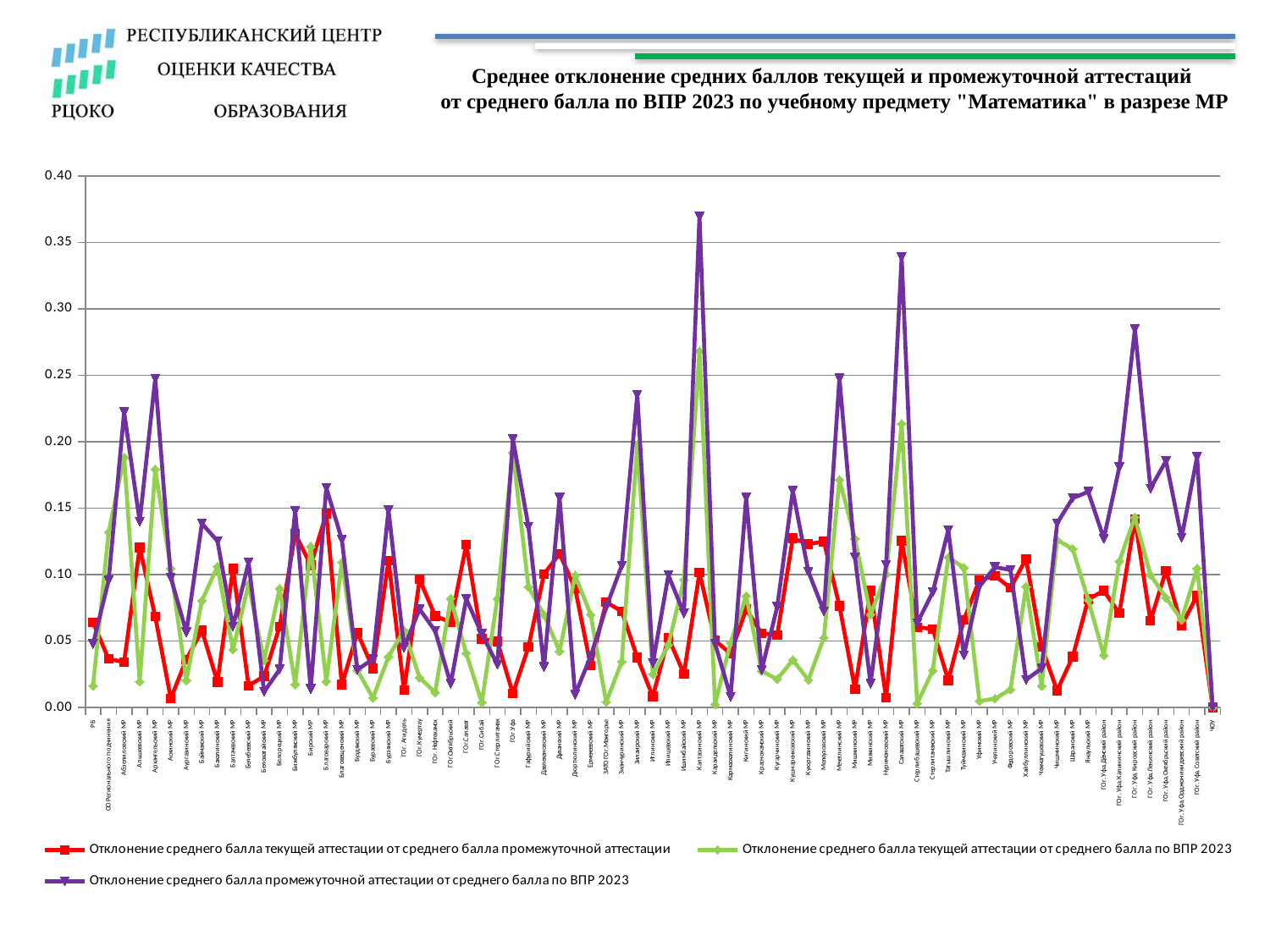
Is the value of the green series for РБ greater or less than 0.05? less What kind of chart is shown on the slide? line chart Which of the three series reaches the highest value anywhere on the chart? Отклонение среднего балла промежуточной аттестации от среднего балла по ВПР 2023 Which series is drawn in red according to the legend? Отклонение среднего балла текущей аттестации от среднего балла промежуточной аттестации Is the value of the purple series for ЧОУ greater or less than 0.05? less Is the highest point of the purple series (Отклонение среднего балла промежуточной аттестации от среднего балла по ВПР 2023) greater or less than 0.35? greater How many series does the legend list? 3 Which subject is named in the chart title? Математика